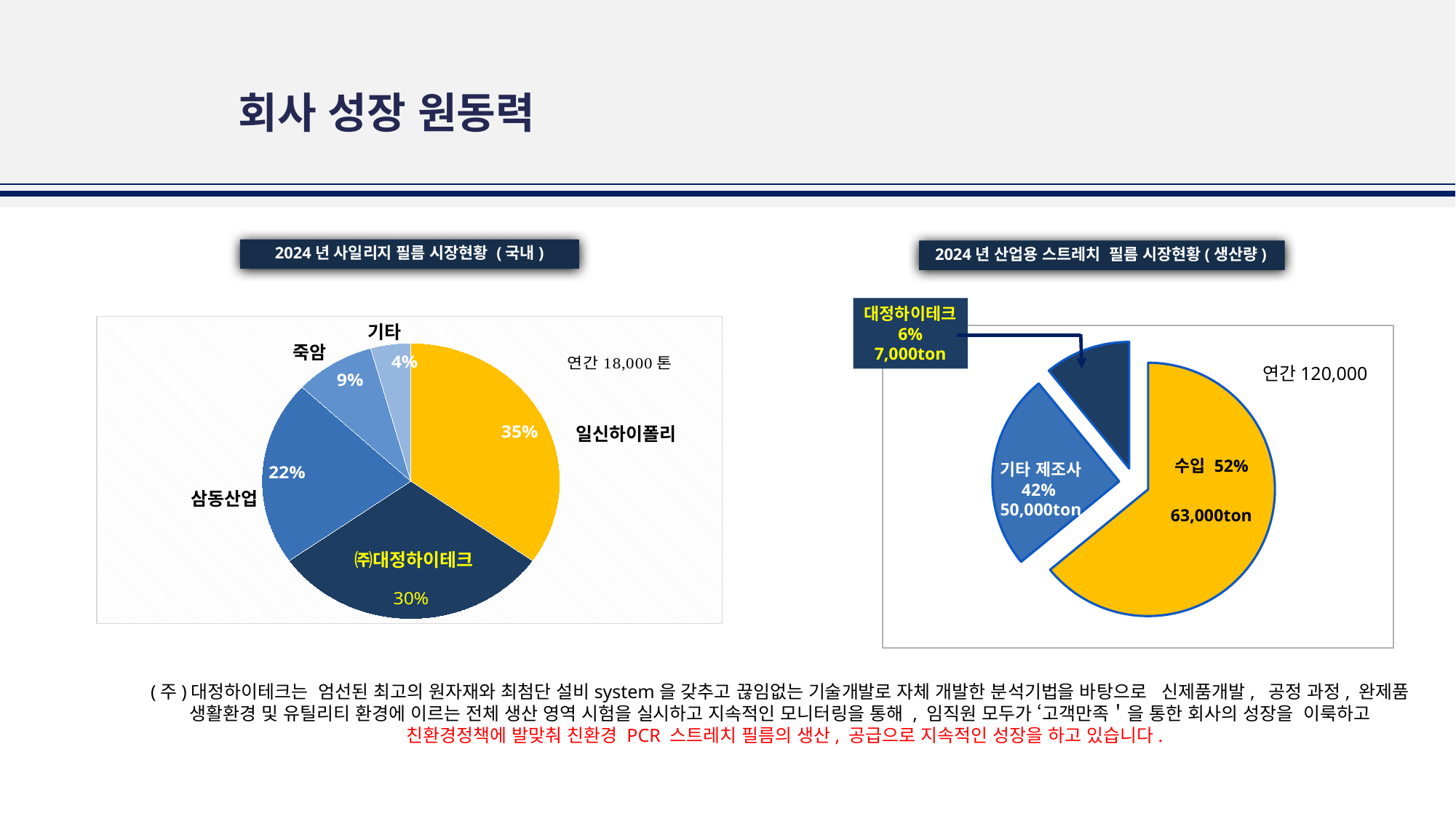
In the left chart (2024년 사일리지 필름 시장현황 (국내)), what is the difference in share between 죽암 and 기타? 5% What kind of chart is shown on the right side of the slide? Pie chart In the left chart (2024년 사일리지 필름 시장현황 (국내)), which category has the smallest share? 기타 In the right chart (2024년 산업용 스트레치 필름 시장현황 (생산량)), what is the production volume for 수입? 63,000ton In the left chart (2024년 사일리지 필름 시장현황 (국내)), what share does 삼동산업 hold? 22% In the left chart (2024년 사일리지 필름 시장현황 (국내)), how many slices does the pie have? 5 In the right chart (2024년 산업용 스트레치 필름 시장현황 (생산량)), which is larger, 수입 or 기타 제조사? 수입 In the left chart (2024년 사일리지 필름 시장현황 (국내)), what share does 일신하이폴리 hold? 35% In the right chart (2024년 산업용 스트레치 필름 시장현황 (생산량)), what is the production volume for 대정하이테크? 7,000ton In the right chart (2024년 산업용 스트레치 필름 시장현황 (생산량)), what share does 기타 제조사 hold? 42% In the left chart (2024년 사일리지 필름 시장현황 (국내)), what share does ㈜대정하이테크 hold? 30% In the left chart (2024년 사일리지 필름 시장현황 (국내)), which category has the largest share? 일신하이폴리